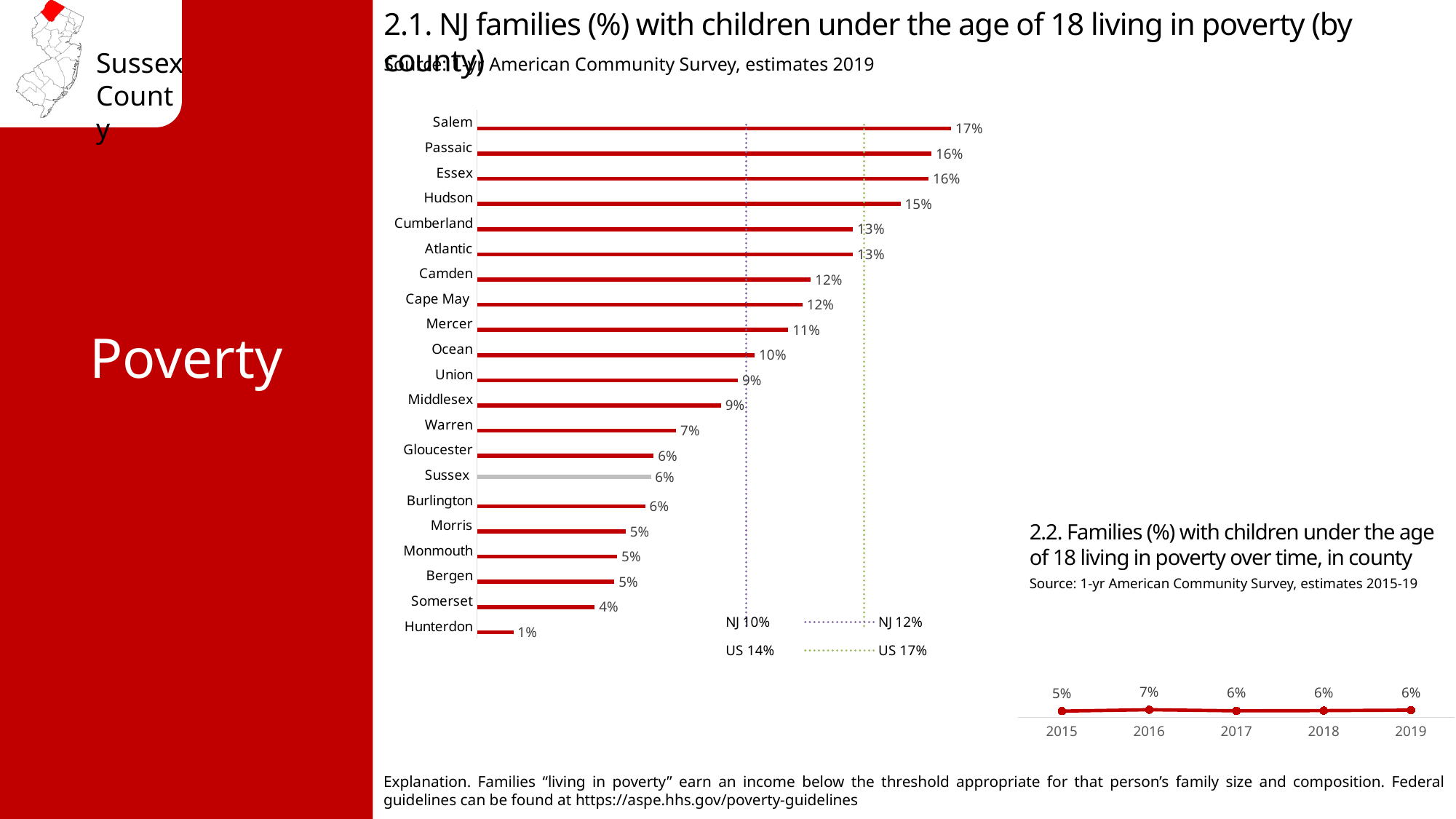
In chart 2.1, which county has the lowest percentage? Hunterdon In chart 2.2, which year has the lowest value? 2015 What type of chart is chart 2.1? Bar chart In chart 2.1, what is the value for Hudson? 15% In chart 2.1 (NJ families with children under 18 living in poverty by county), what is the value for Sussex? 6% In chart 2.1, what is the difference between the values for Salem and Hunterdon? 16% In chart 2.1, which is larger, the value for Mercer or the value for Warren? Mercer How many counties are shown in chart 2.1? 21 In chart 2.1, which county has the highest percentage of families with children living in poverty? Salem How many years are plotted in chart 2.2? 5 In chart 2.2 (families with children under 18 living in poverty over time), what is the value for 2016? 7%